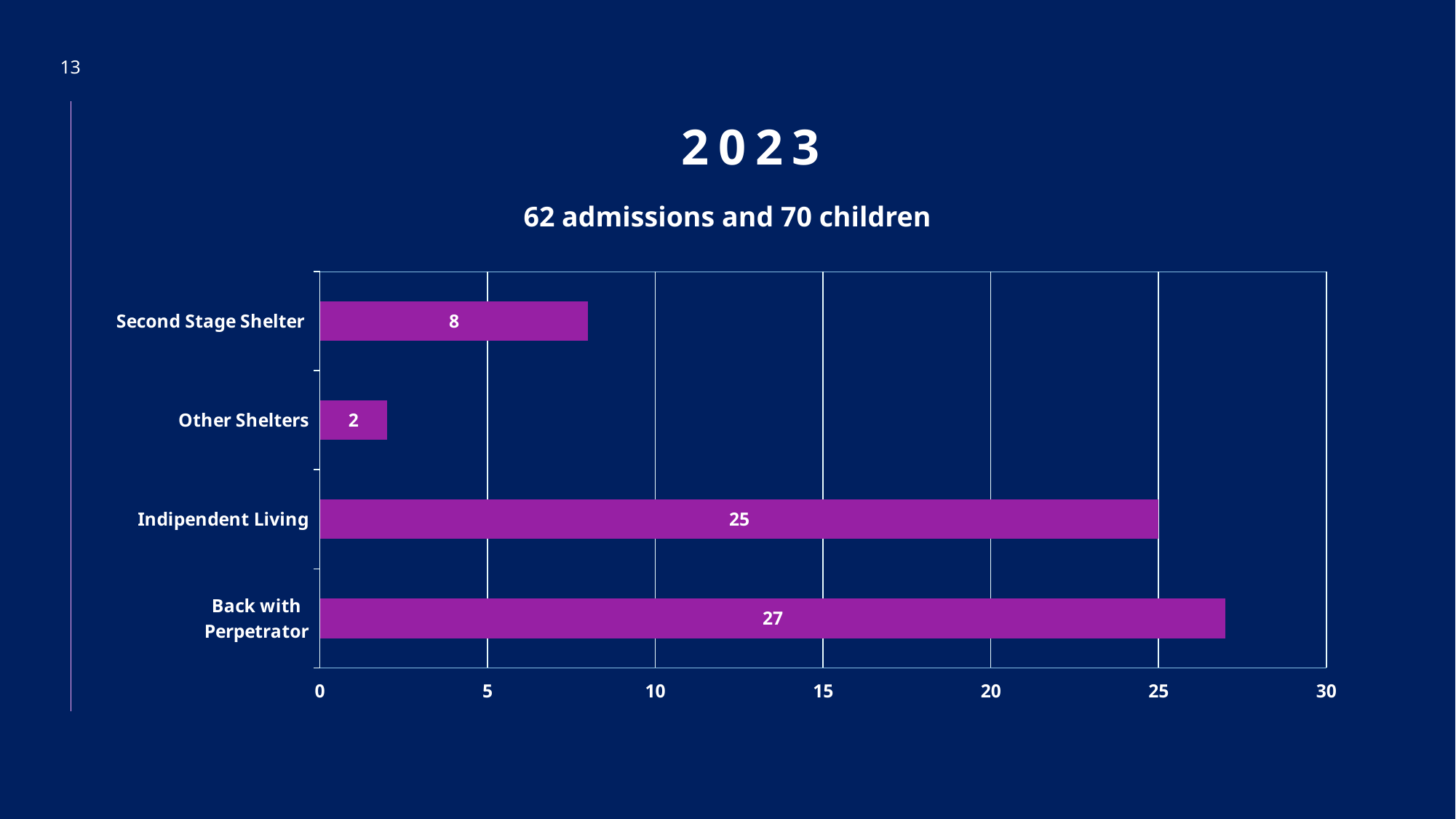
Is the value for Indipendent Living greater or less than 20? greater What is the difference between the values for Back with Perpetrator and Indipendent Living? 2 What is the value for Other Shelters? 2 What is the value for Back with Perpetrator? 27 Which is larger, the value for Second Stage Shelter or the value for Other Shelters? Second Stage Shelter Which category has the lowest value? Other Shelters How many categories are shown in the chart? 4 What kind of chart is shown on the slide? Bar chart Which category has the highest value? Back with Perpetrator What is the value for Indipendent Living? 25 What is the value for Second Stage Shelter? 8 What is the difference between the values for Second Stage Shelter and Other Shelters? 6